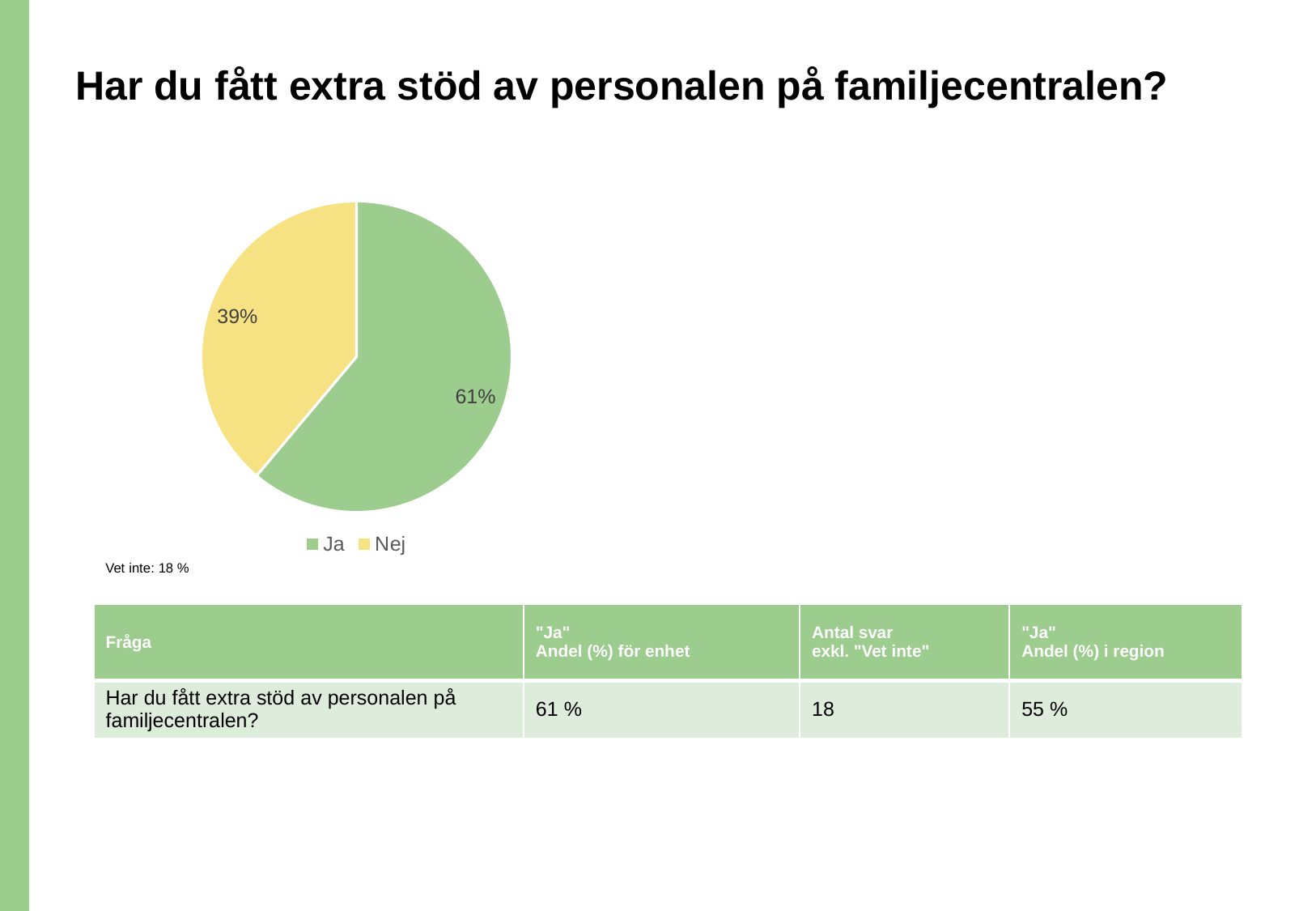
How many entries does the legend list? 2 What share of the pie does "Ja" represent? 61% Which is larger, the "Ja" slice or the "Nej" slice? Ja Is the share for "Nej" greater or less than 50%? less What kind of chart is shown on the slide? pie chart What share of the pie does "Nej" represent? 39% Which slice of the pie is the largest? Ja What colour is the "Ja" slice in the pie chart? green Which slice of the pie is the smallest? Nej What colour is the "Nej" slice in the pie chart? yellow What is the difference in percentage points between the "Ja" and "Nej" slices? 22 How many slices does the pie chart have? 2